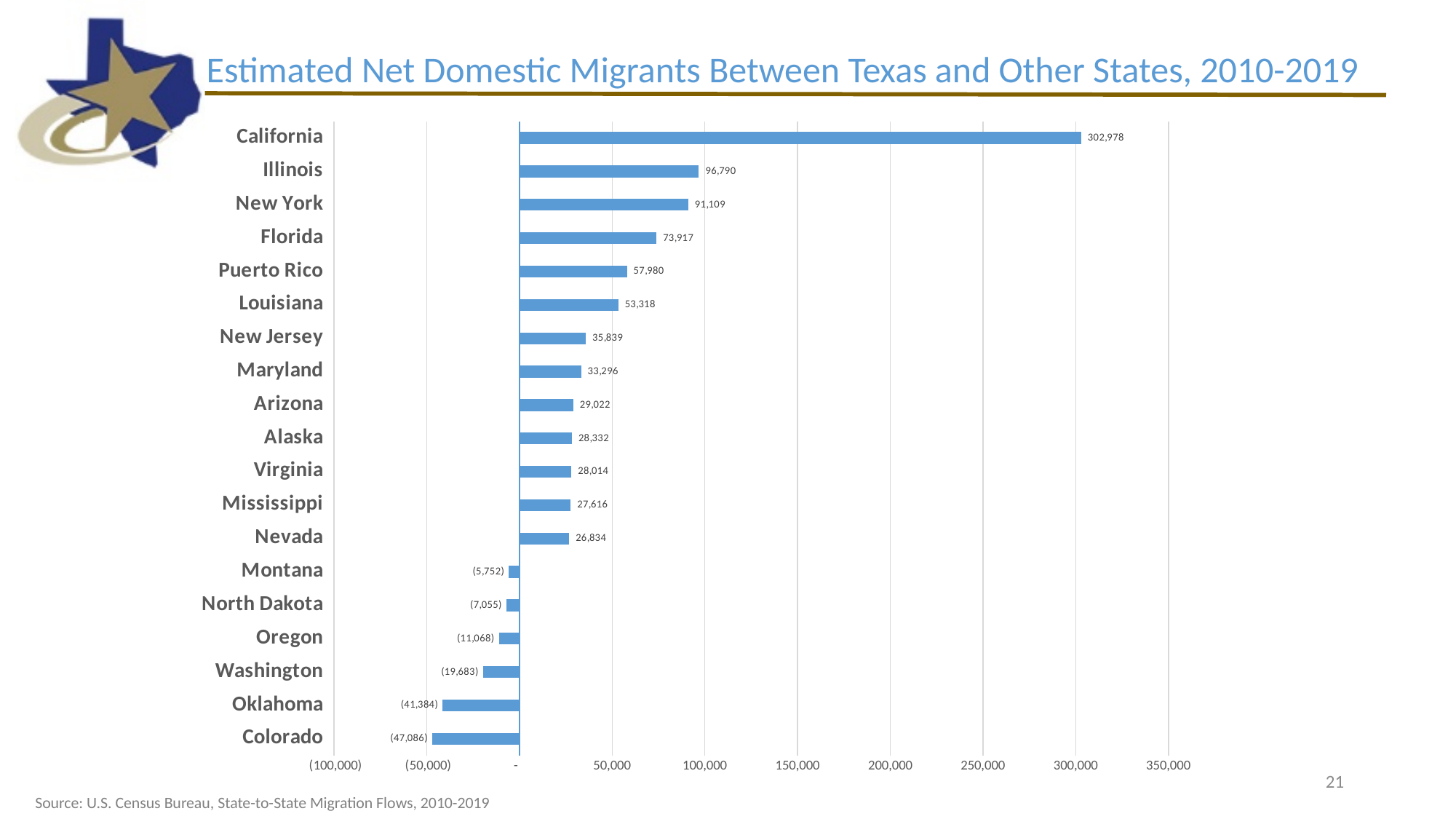
What is the title of the chart? Estimated Net Domestic Migrants Between Texas and Other States, 2010-2019 How many categories on the chart have negative values? 6 What kind of chart is shown on the slide? bar chart What is the estimated net domestic migration value for California? 302,978 Is the value for New Jersey greater or less than 50,000? less Which state has the highest net domestic migration to Texas? California What is the difference between the values for Illinois and New York? 5,681 How many states or territories are shown on the chart? 19 Which has a larger value, Florida or Puerto Rico? Florida What is the value shown for Colorado? (47,086) Which state has the lowest (most negative) value on the chart? Colorado What is the value shown for Louisiana? 53,318